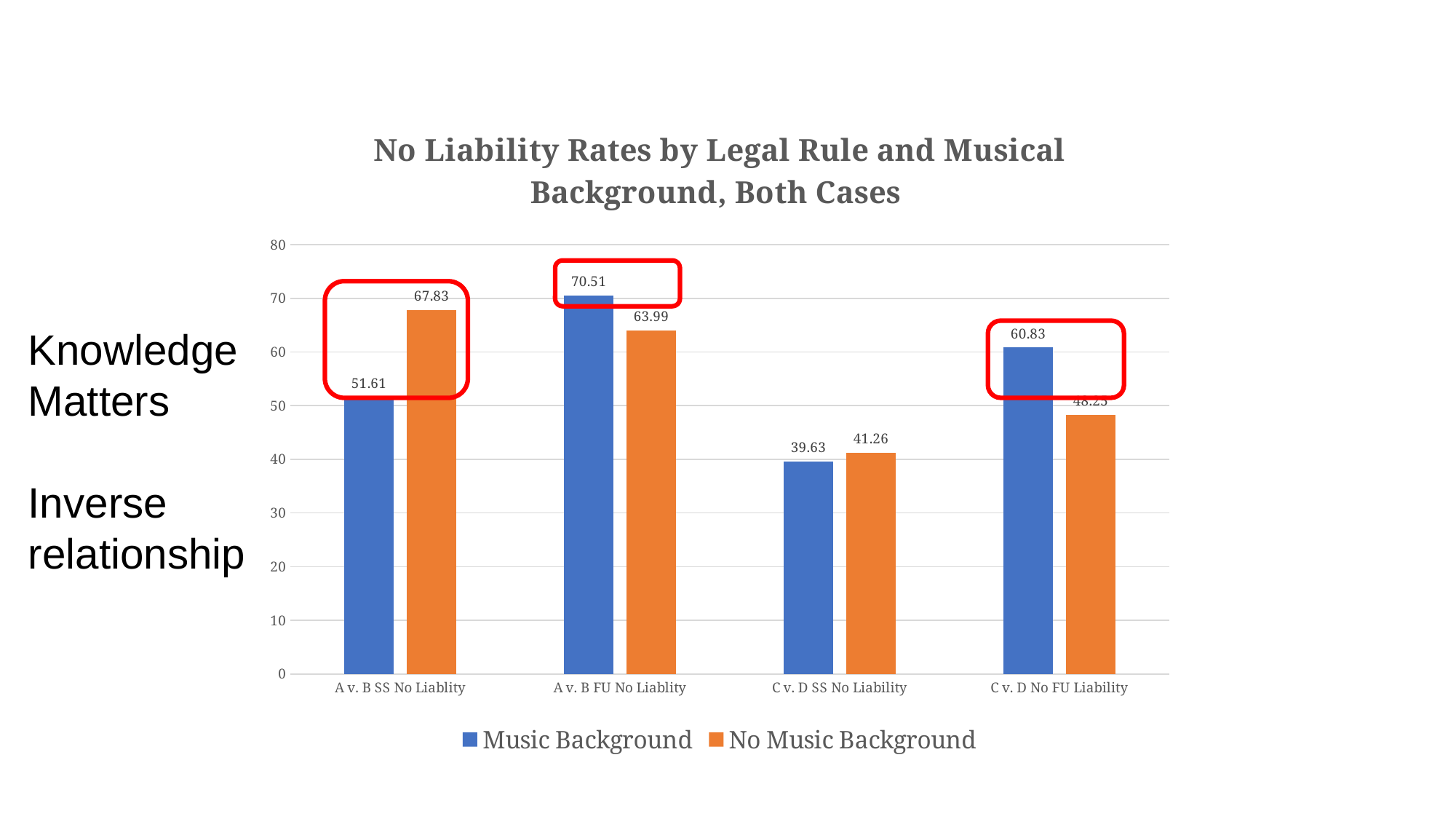
Which category has the highest Music Background value? A v. B FU No Liablity What is the No Music Background value for A v. B SS No Liablity? 67.83 What is the Music Background value for C v. D SS No Liability? 39.63 Which category has the lowest No Music Background value? C v. D SS No Liability For A v. B FU No Liablity, which series has the larger value, Music Background or No Music Background? Music Background How many series does the legend list? 2 What is the difference between the No Music Background and Music Background values for A v. B SS No Liablity? 16.22 Is the No Music Background value for C v. D No FU Liability greater or less than 50? less How many categories are shown on the x axis? 4 What is the title of the chart? No Liability Rates by Legal Rule and Musical Background, Both Cases What type of chart is shown on the slide? bar chart What is the Music Background value for A v. B FU No Liablity? 70.51